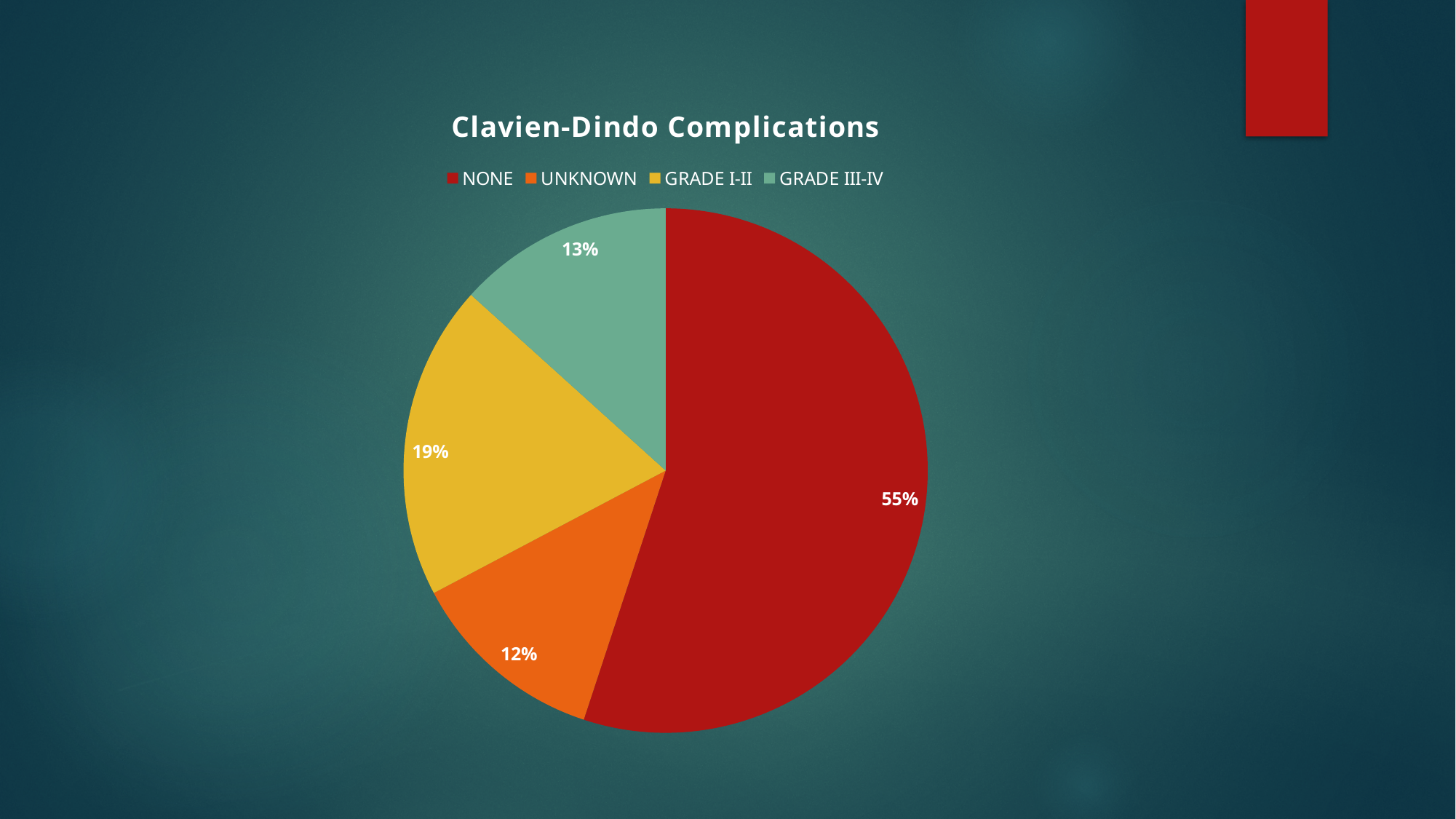
What is the title of the chart? Clavien-Dindo Complications What colour is the slice representing GRADE III-IV? Green What is the difference in percentage points between the NONE slice and the GRADE I-II slice? 36 Which category has the smallest slice of the pie? UNKNOWN What percentage of the pie is labelled UNKNOWN? 12% What percentage of the pie is labelled NONE? 55% Which slice is larger, GRADE I-II or GRADE III-IV? GRADE I-II Which category has the largest slice of the pie? NONE What percentage of the pie is labelled GRADE III-IV? 13% How many categories does the legend list? 4 What type of chart is shown on the slide? Pie chart What percentage of the pie is labelled GRADE I-II? 19%